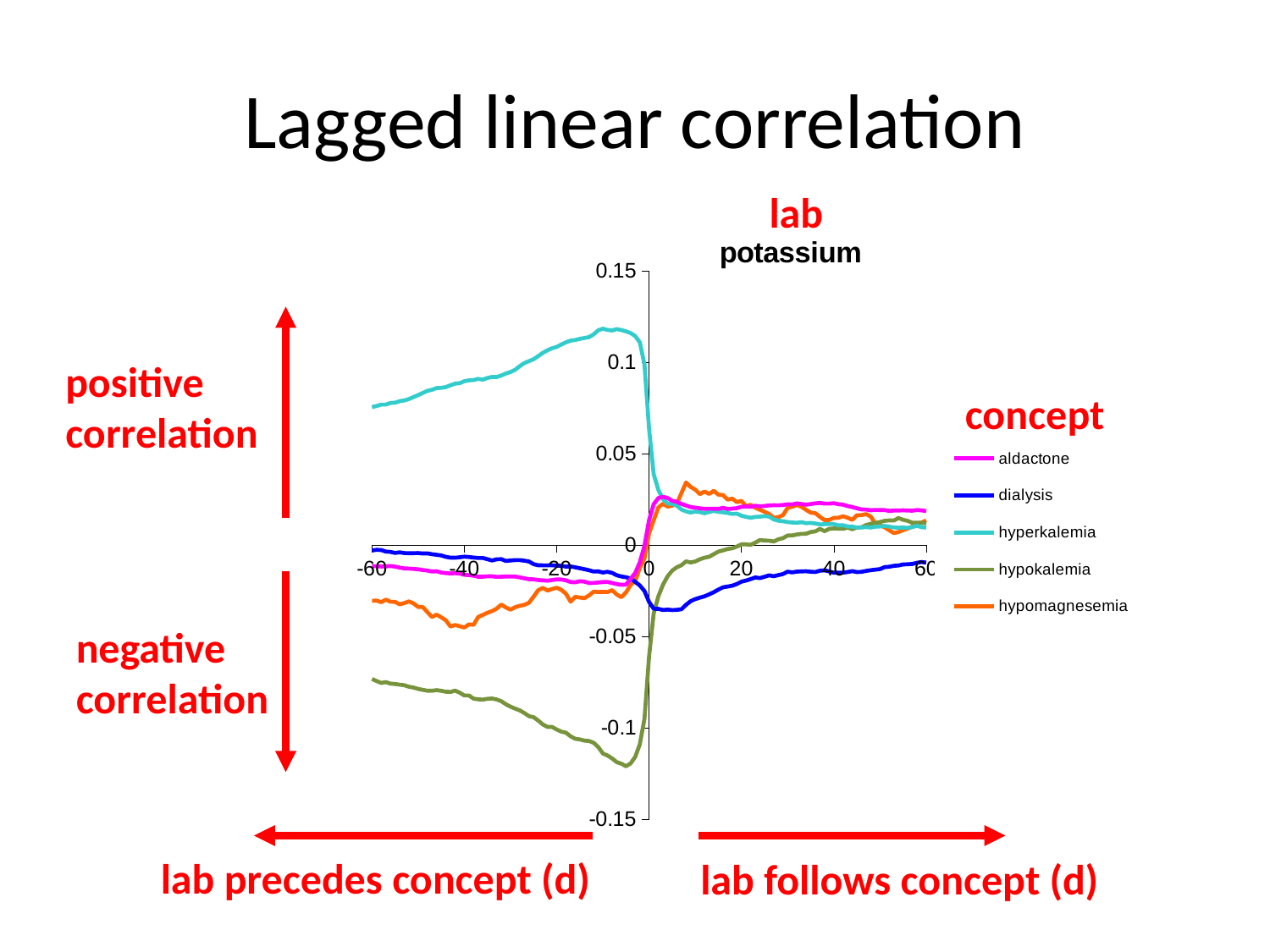
Does the dialysis line rise or fall as the lag goes from 0 to 60? rises Which series has the highest value at lag -60? hyperkalemia At lag -40, which series has the larger value, hyperkalemia or aldactone? hyperkalemia Which series has the lowest value at lag -60? hypokalemia How many series does the legend list? 5 Is the value for hyperkalemia at lag -10 greater or less than 0.1? greater Is the value for hypomagnesemia at lag -40 greater or less than 0? less Does the hyperkalemia line rise or fall as the lag goes from -60 to -10? rises Does the hypokalemia line rise or fall as the lag goes from -60 to -10? falls What is the title of the chart? potassium Is the value for hypokalemia at lag -10 greater or less than -0.1? less What kind of chart is shown on the slide? line chart